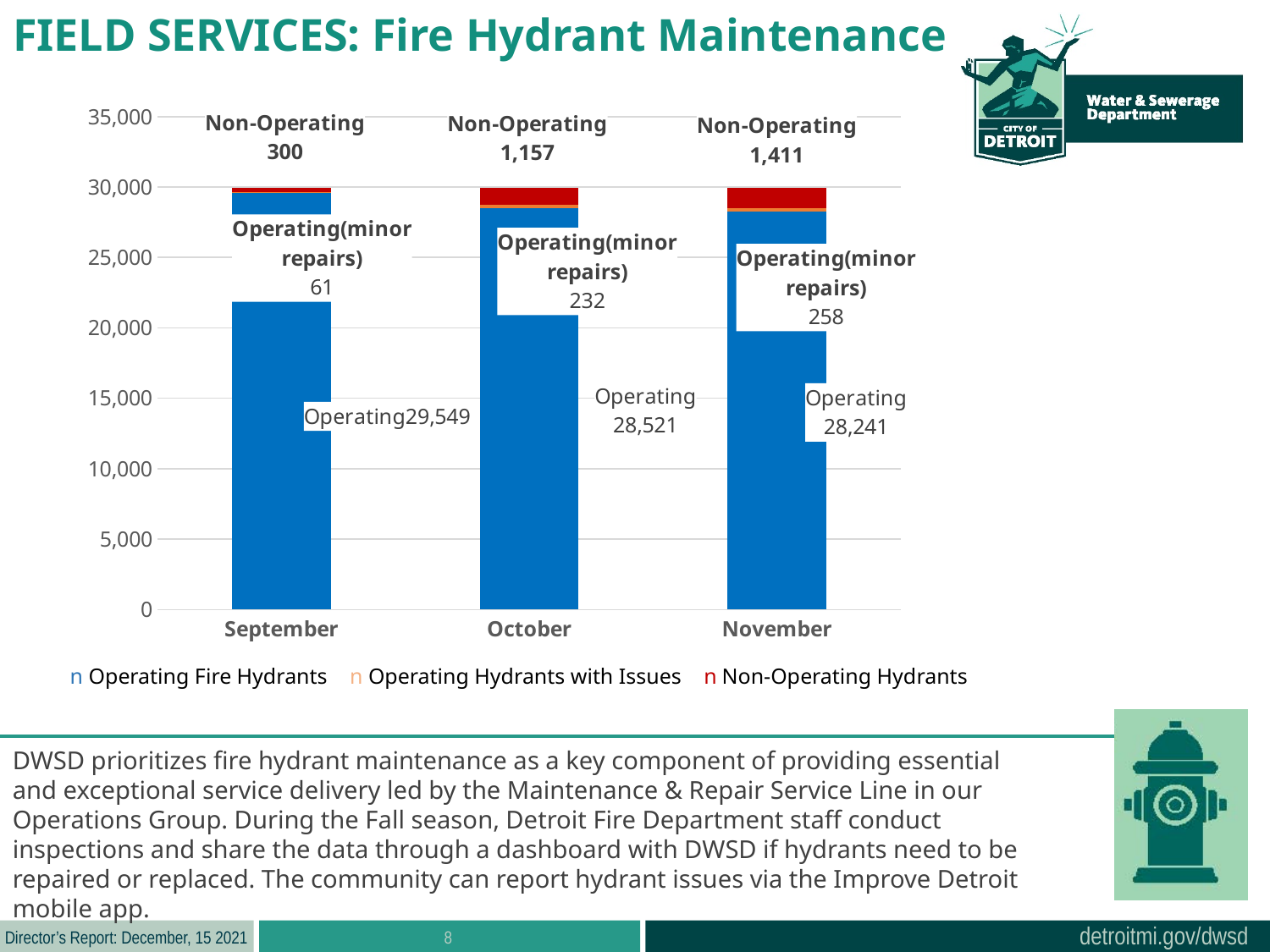
What is the total height of the stacked bar for October? 29,910 What is the difference in operating fire hydrants between September and November? 1,308 How many months are shown on the x axis of the chart? 3 Which month has more non-operating hydrants, September or October? October How many operating hydrants with minor repairs were recorded in October? 232 Which month has the lowest number of operating hydrants with minor repairs? September Do the operating fire hydrant values rise or fall from September to November? Fall How many series does the legend list? 3 Which month has the highest number of non-operating hydrants? November What is the number of non-operating hydrants in November? 1,411 What kind of chart is shown on the slide? Stacked bar chart How many operating fire hydrants were there in September? 29,549